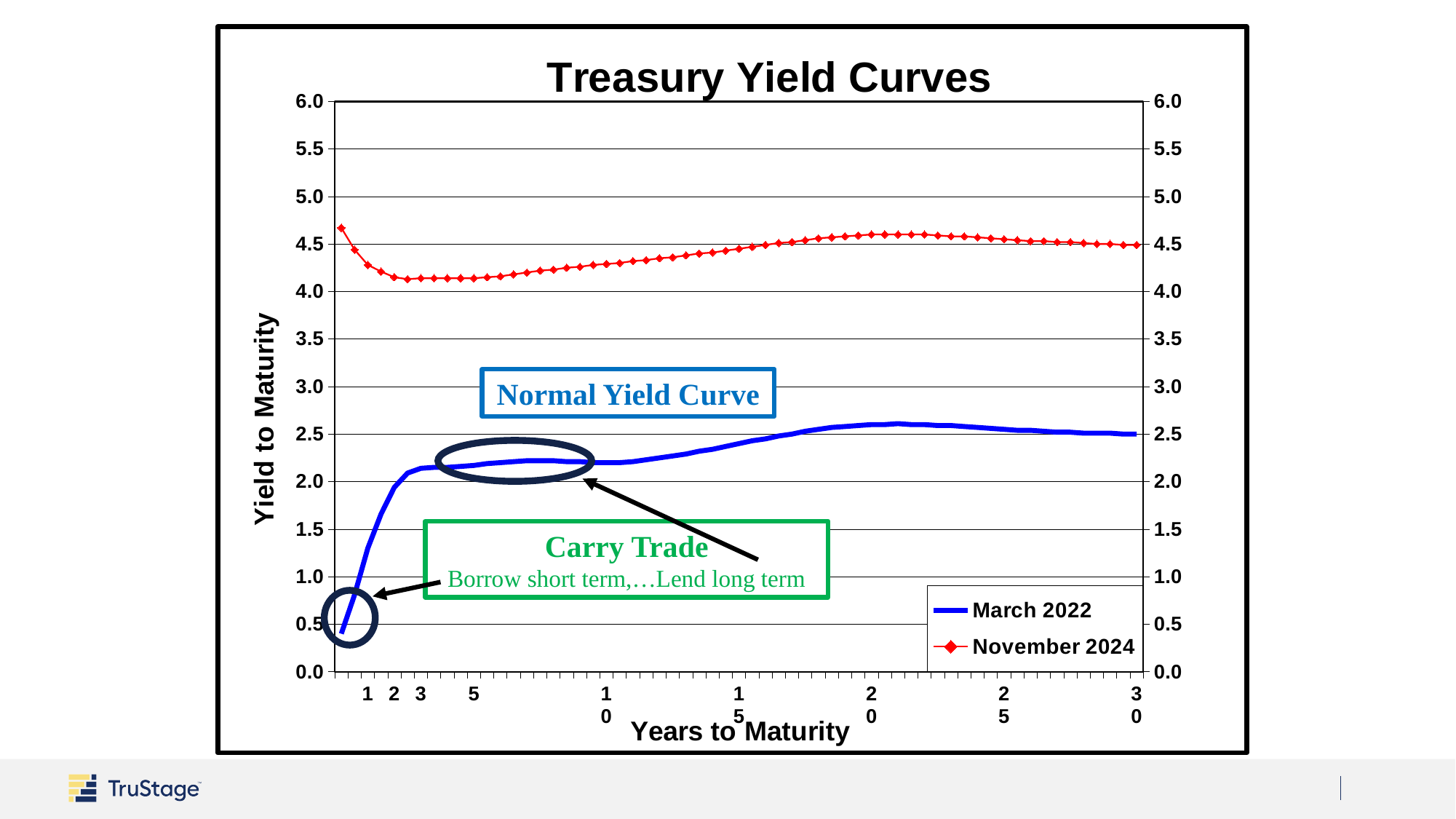
What kind of chart is shown on the slide? Line chart Is the November 2024 yield at 5 years to maturity greater or less than 4.5? less Is the March 2022 yield at 10 years to maturity greater or less than 2.0? greater Is the November 2024 yield at 5 years to maturity greater or less than 4.0? greater At 10 years to maturity, which series has the higher yield, March 2022 or November 2024? November 2024 What is the title of the chart? Treasury Yield Curves Which two series are listed in the legend? March 2022 and November 2024 Does the November 2024 yield curve rise or fall between 1 and 3 years to maturity? Fall Does the March 2022 yield curve rise or fall between 1 and 5 years to maturity? Rise How many series does the legend list? 2